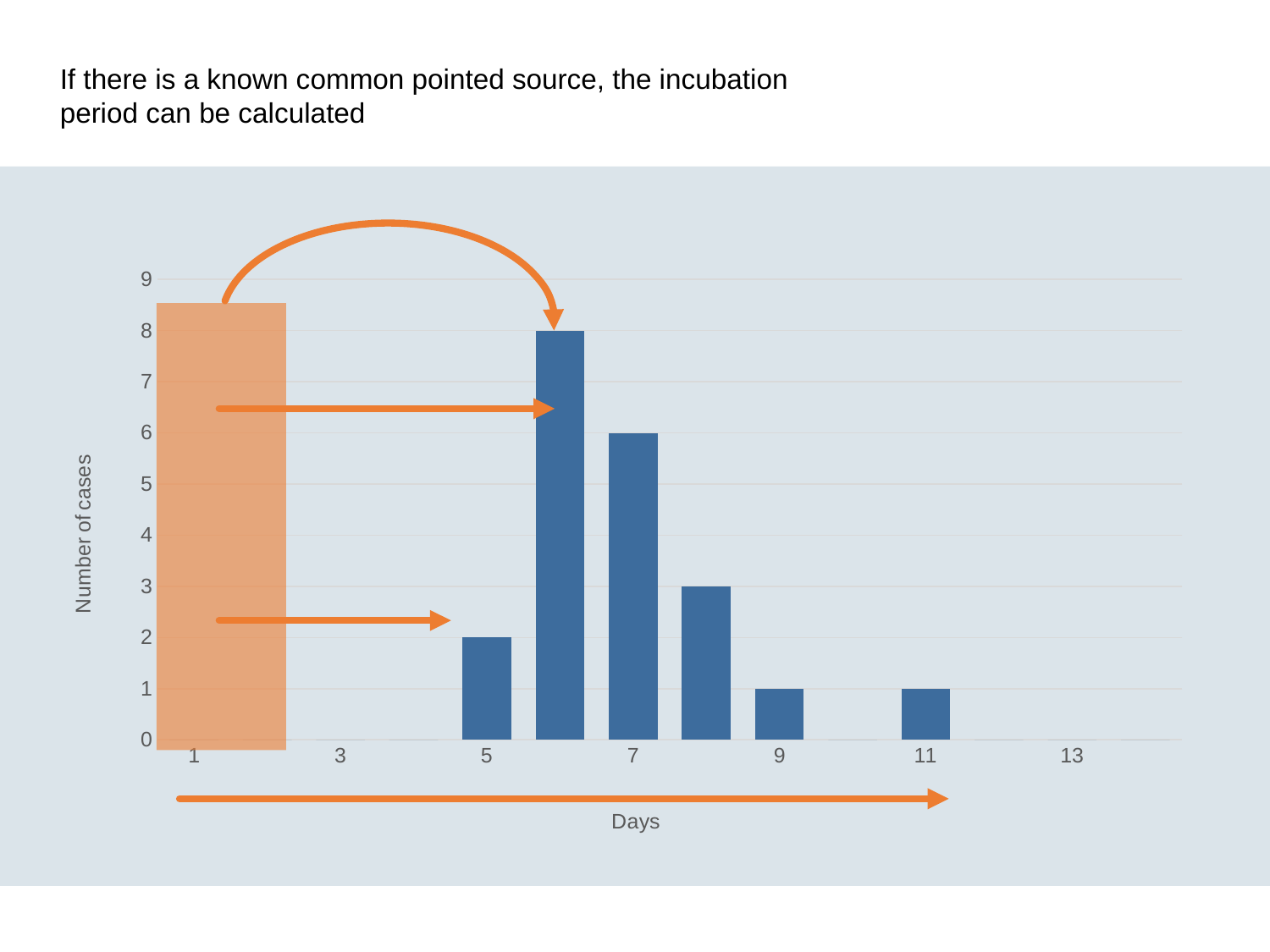
What is the number of cases on day 11? 1 What is the number of cases on day 5? 2 What is the highest number of cases reached by any bar in the chart? 8 Is the number of cases on day 7 greater or less than 5? greater What kind of chart is shown on the slide? bar chart How many bars are plotted in the chart? 6 What is the number of cases on day 7? 6 What is the difference in number of cases between day 7 and day 5? 4 What is the label of the x axis? Days Which day has more cases, day 5 or day 7? day 7 Do the number of cases rise or fall from day 7 to day 9? fall What is the number of cases on day 9? 1